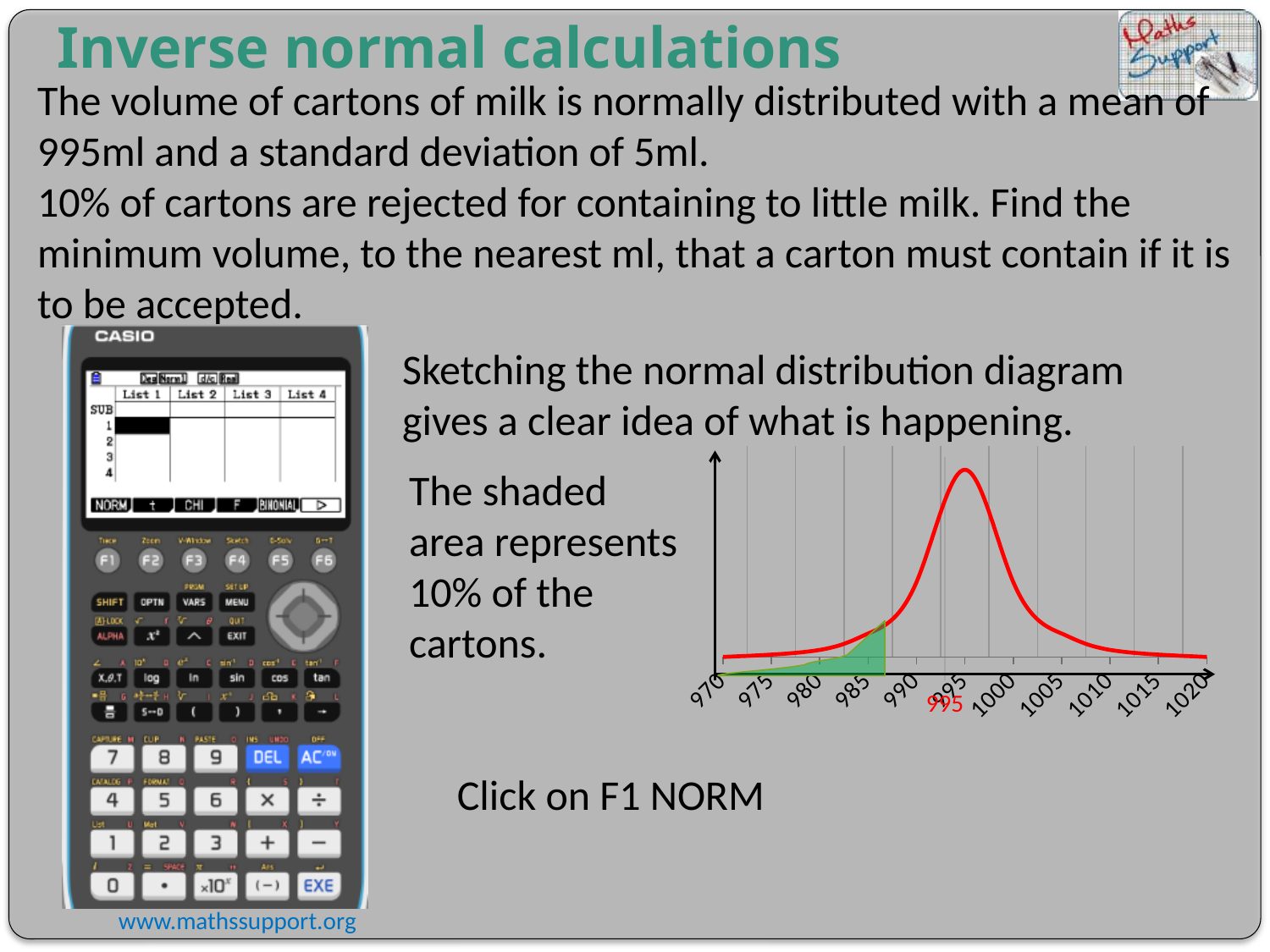
What percentage of the cartons does the shaded area in the normal distribution diagram represent? 10% What kind of chart is the normal distribution diagram on the slide? Line chart What colour is the shaded area under the curve in the normal distribution diagram? Green Is the curve in the normal distribution diagram higher at 990 or at 1010? 990 Does the curve in the normal distribution diagram rise or fall as x increases from 995 to 1020? Fall What is the smallest value labelled on the x axis of the normal distribution diagram? 970 At which x-axis value does the curve in the normal distribution diagram reach its peak? 995 Which x-axis label in the normal distribution diagram is written in red? 995 What is the largest value labelled on the x axis of the normal distribution diagram? 1020 How many labelled tick values are shown on the x axis of the normal distribution diagram? 11 Is the shaded area in the normal distribution diagram to the left or to the right of 995? Left Does the curve in the normal distribution diagram rise or fall as x increases from 970 to 995? Rise